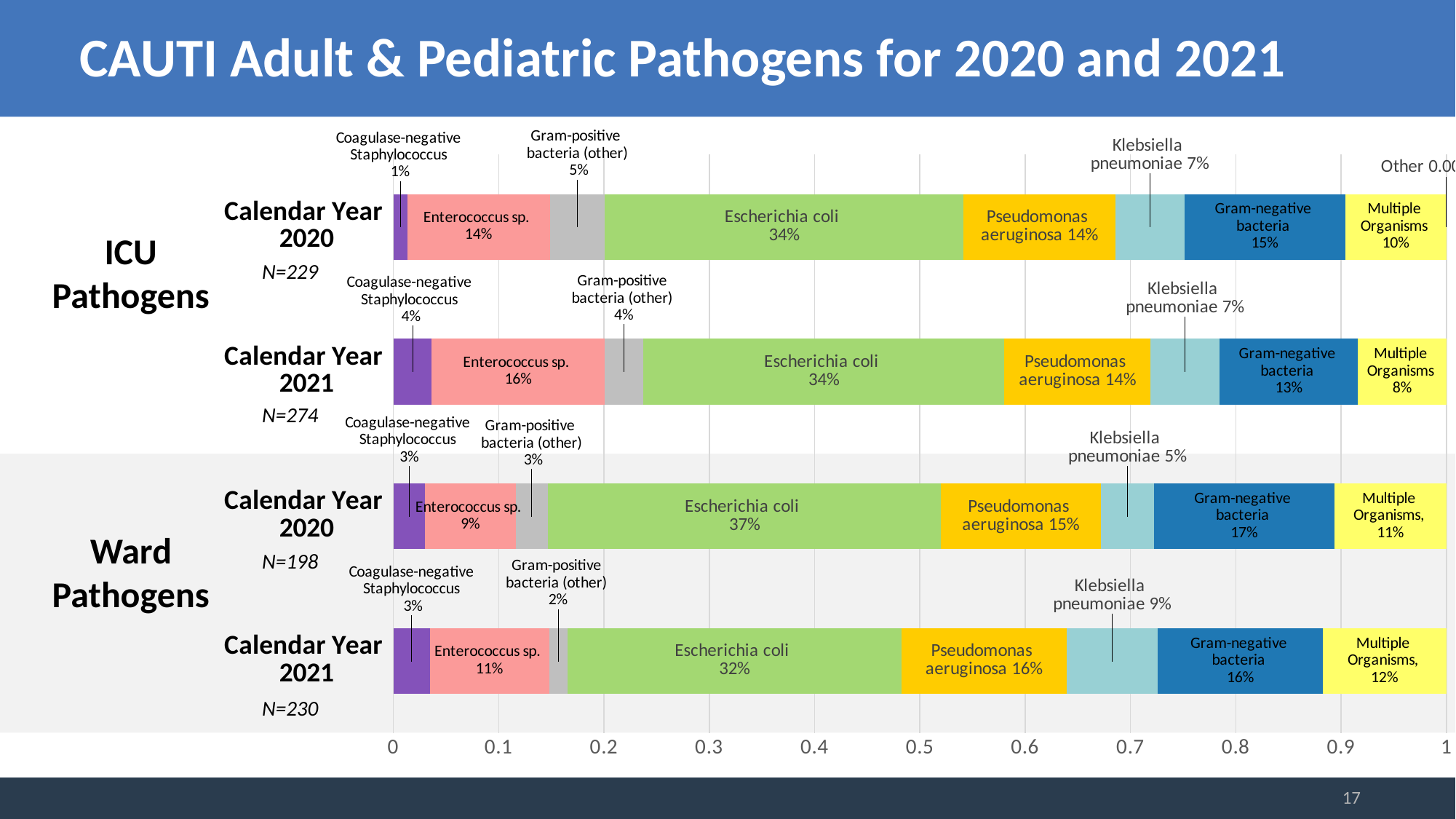
By how many percentage points did the Gram-negative bacteria share of ICU pathogens change from Calendar Year 2020 to Calendar Year 2021? 2 percentage points What percentage of ICU pathogens in Calendar Year 2020 was Escherichia coli? 34% What is the N value for Ward pathogens in Calendar Year 2020? N=198 What colour are the Escherichia coli segments in the chart? Green Which labelled pathogen has the smallest share of Ward pathogens in Calendar Year 2021? Gram-positive bacteria (other) What percentage of ICU pathogens in Calendar Year 2021 was Multiple Organisms? 8% Which pathogen has the largest share of Ward pathogens in Calendar Year 2020? Escherichia coli What percentage of Ward pathogens in Calendar Year 2021 was Klebsiella pneumoniae? 9% How many bars are shown in the chart? 4 What kind of chart is shown on the slide? Stacked bar chart What share of Ward pathogens in Calendar Year 2021 was Enterococcus sp.? 11% Which had a larger Enterococcus sp. share in Calendar Year 2021, ICU pathogens or Ward pathogens? ICU pathogens